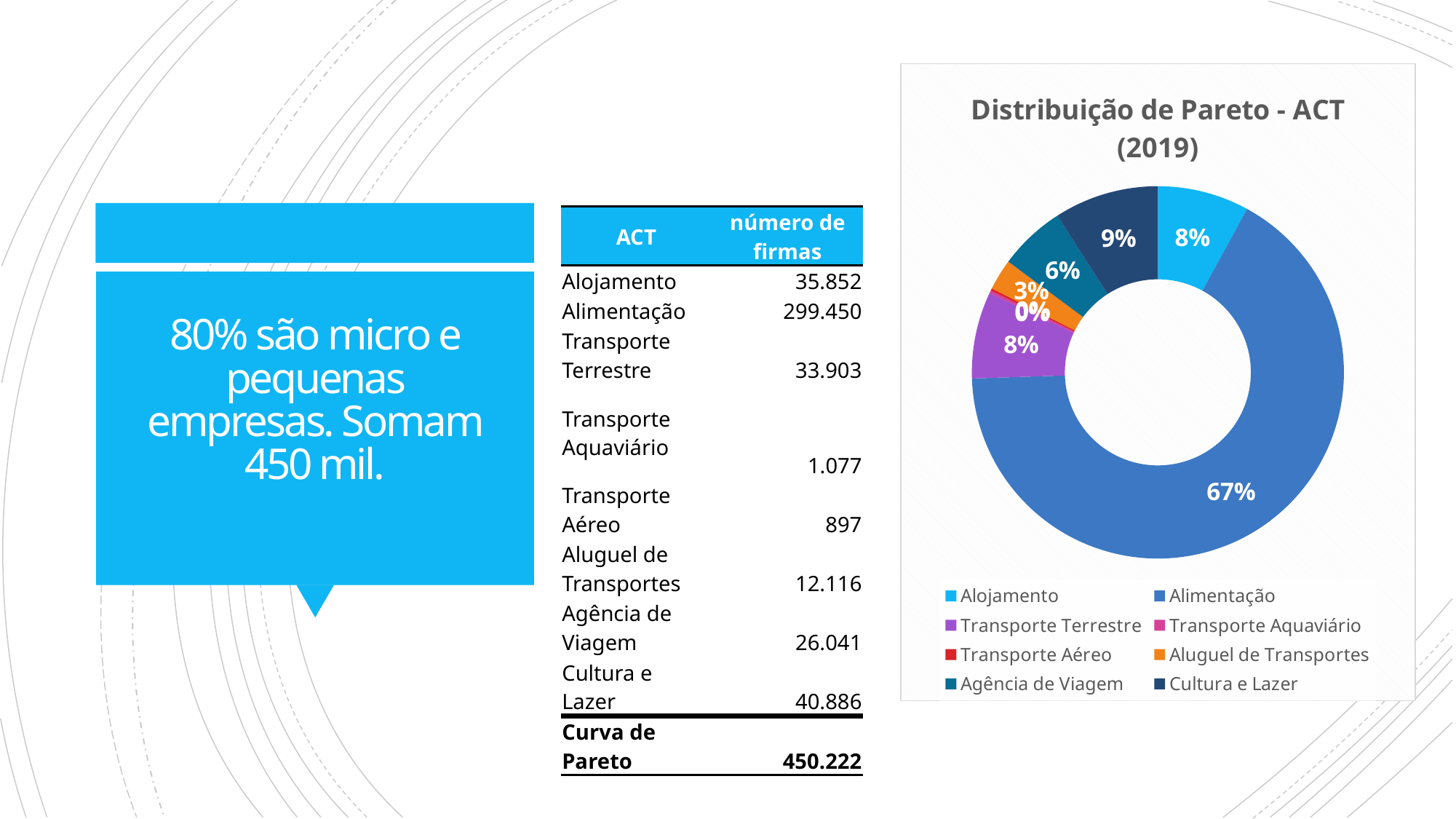
How many categories does the chart's legend list? 8 Which has a larger share, Cultura e Lazer or Agência de Viagem? Cultura e Lazer What kind of chart is shown on the slide? doughnut (pie) chart What is the title of the chart? Distribuição de Pareto - ACT (2019) What share of the chart does Alojamento represent? 8% What share of the chart does Transporte Terrestre represent? 8% Which category has the largest share of the chart? Alimentação What share of the chart does Agência de Viagem represent? 6% What is the difference in percentage points between the shares of Alimentação and Cultura e Lazer? 58%